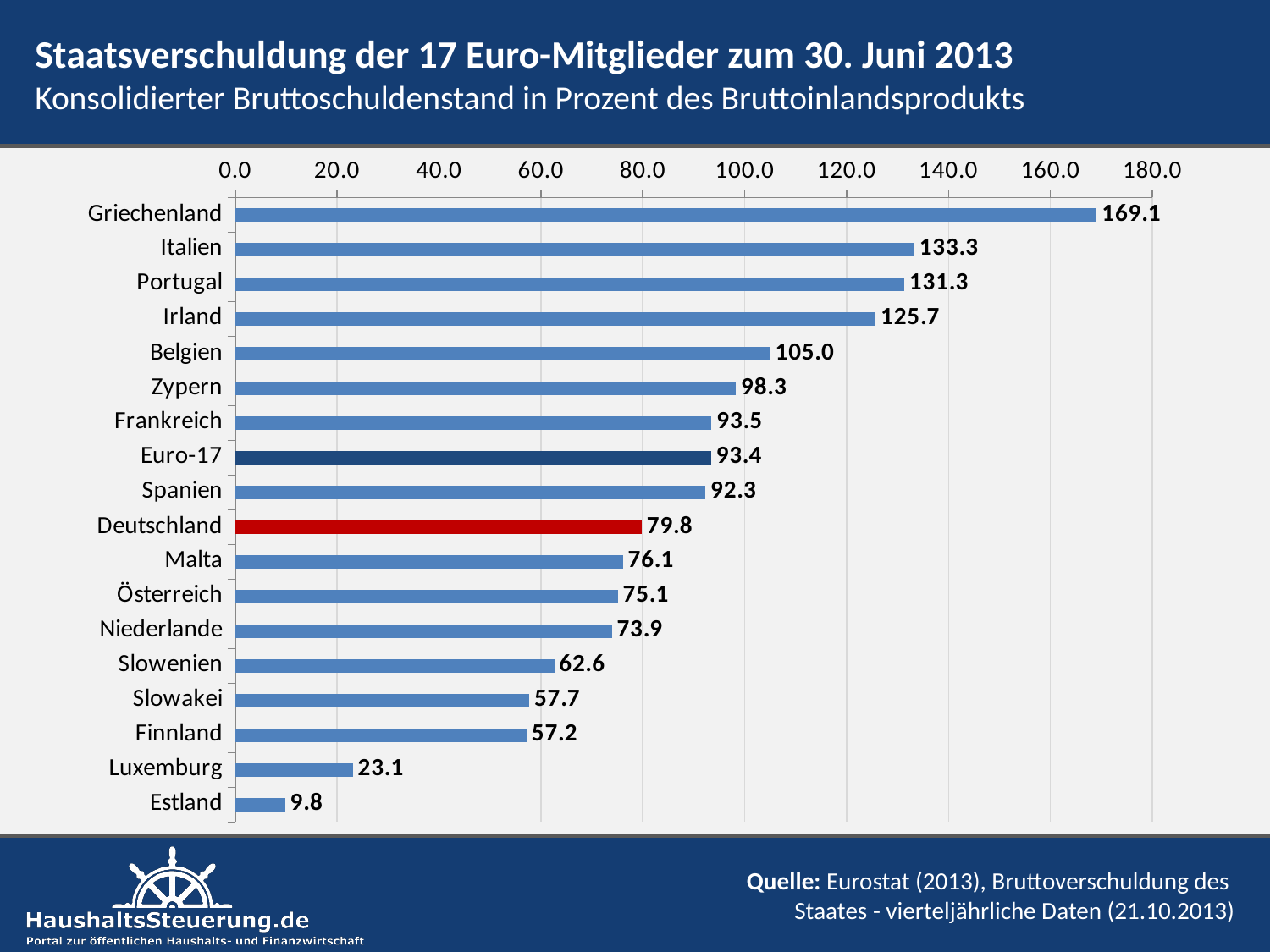
By how much does the value for Griechenland exceed the value for Italien? 35.8 What kind of chart is shown on the slide? Bar chart What is the difference between the values for Luxemburg and Estland? 13.3 Which has a larger value, Belgien or Zypern? Belgien What is the value shown for Estland? 9.8 How many bars are shown in the chart? 18 What is the value shown for Griechenland? 169.1 What is the value shown for Euro-17? 93.4 What is the value shown for Deutschland? 79.8 Which bar is coloured red? Deutschland Which category has the highest value? Griechenland Which category has the lowest value? Estland